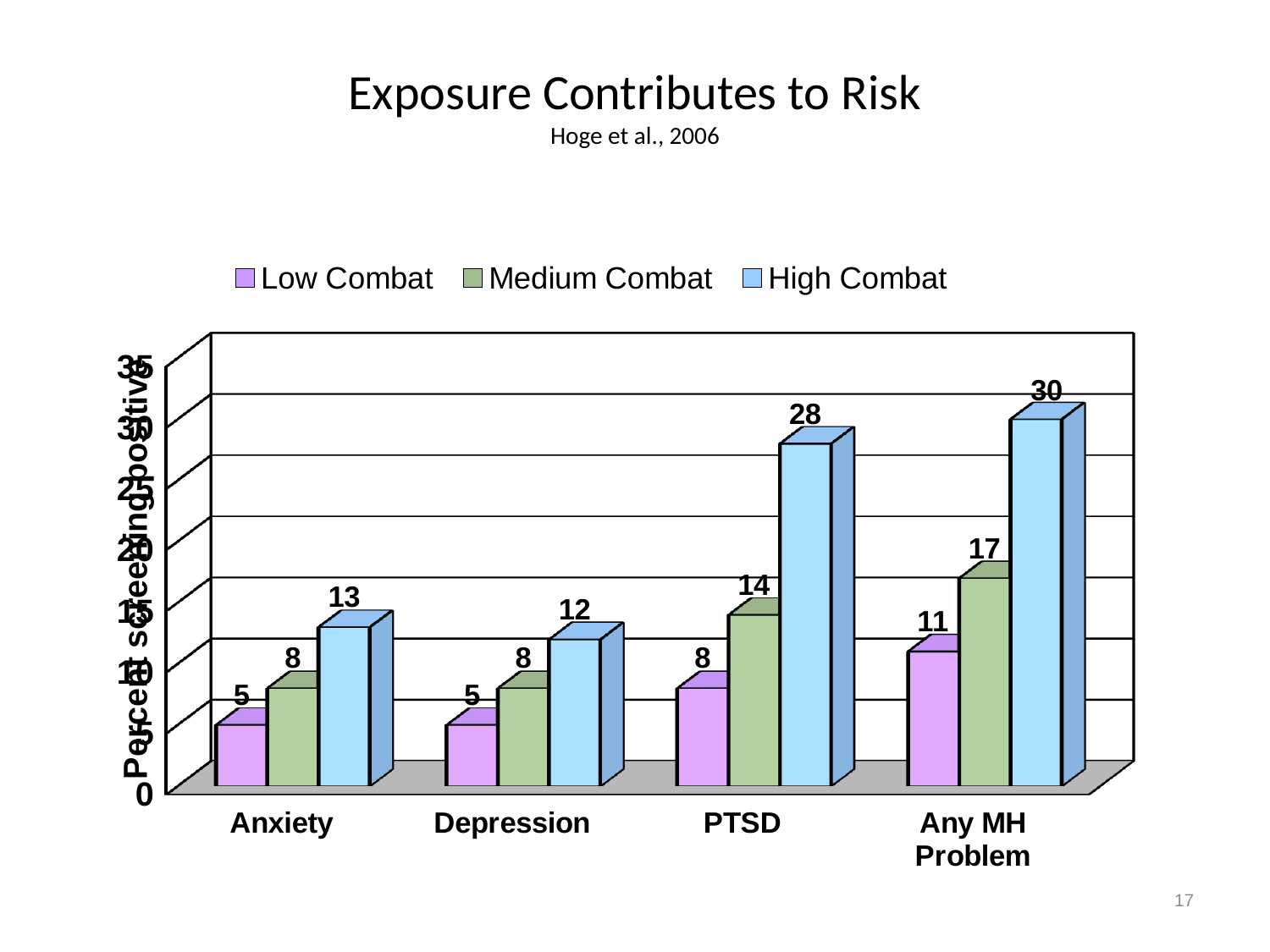
What kind of chart is shown on the slide? Bar chart Which category has the lowest Medium Combat value? Anxiety and Depression (both 8) How many categories are shown on the x axis? 4 Which category has the highest High Combat value? Any MH Problem Which is larger: the High Combat value for Anxiety or the High Combat value for Depression? Anxiety What is the difference between the High Combat and Low Combat values for PTSD? 20 What is the title of the chart on the slide? Exposure Contributes to Risk What is the value for Medium Combat in the Depression category? 8 What is the value for High Combat in the PTSD category? 28 What is the value for Low Combat in the Any MH Problem category? 11 Do the High Combat values rise or fall from Depression to Any MH Problem? Rise How many series does the legend list? 3